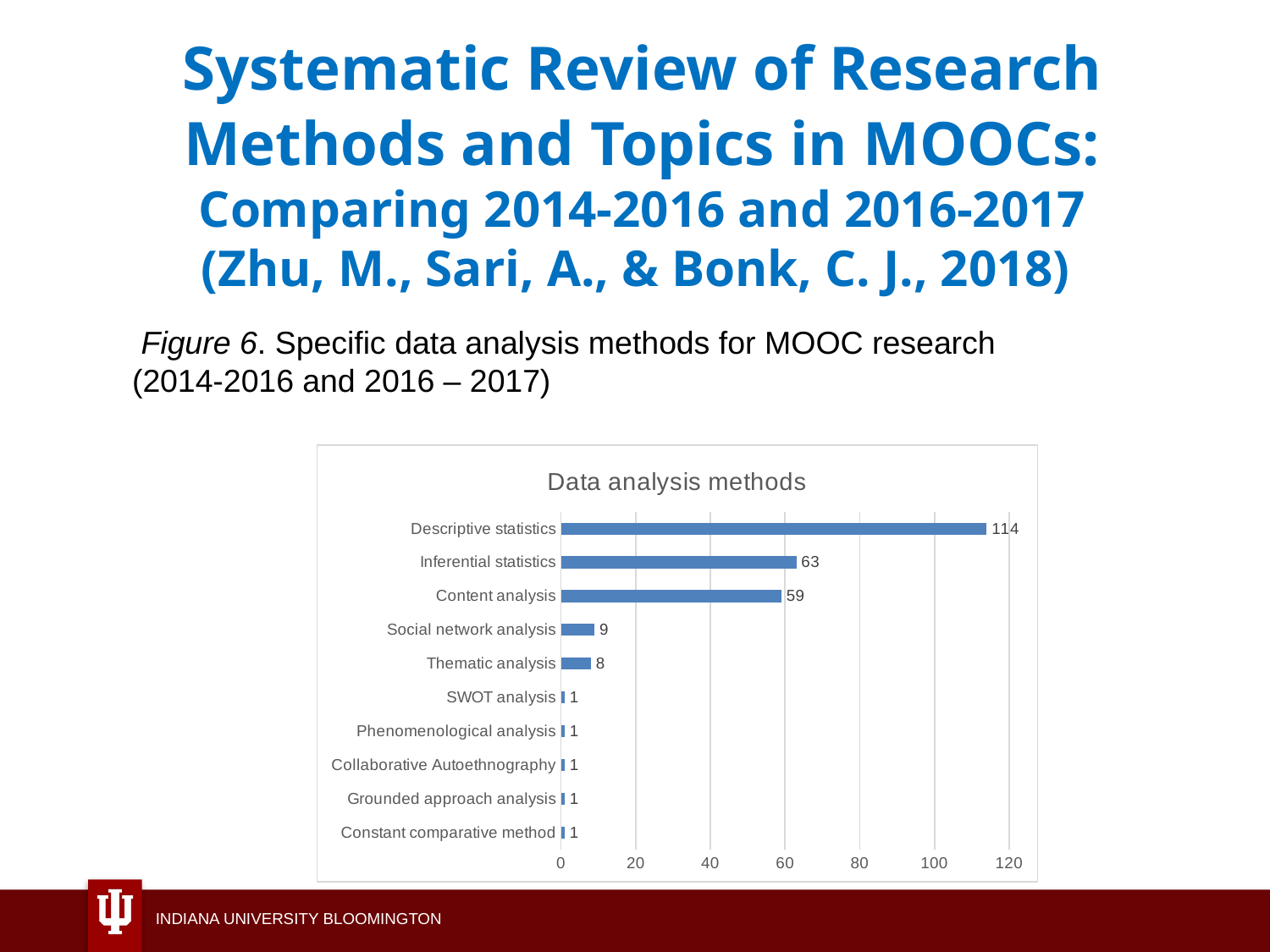
What is the value for Thematic analysis? 8 What kind of chart is shown on the slide? Bar chart What is the value for Inferential statistics? 63 How many data analysis methods are shown in the chart? 10 What is the value for Descriptive statistics? 114 What is the difference between the values for Descriptive statistics and Inferential statistics? 51 What is the value for Social network analysis? 9 Is the value for Descriptive statistics greater or less than 100? greater Which data analysis method has the highest value? Descriptive statistics What is the value for Content analysis? 59 Which is larger, the value for Social network analysis or the value for Thematic analysis? Social network analysis What is the difference between the values for Inferential statistics and Content analysis? 4